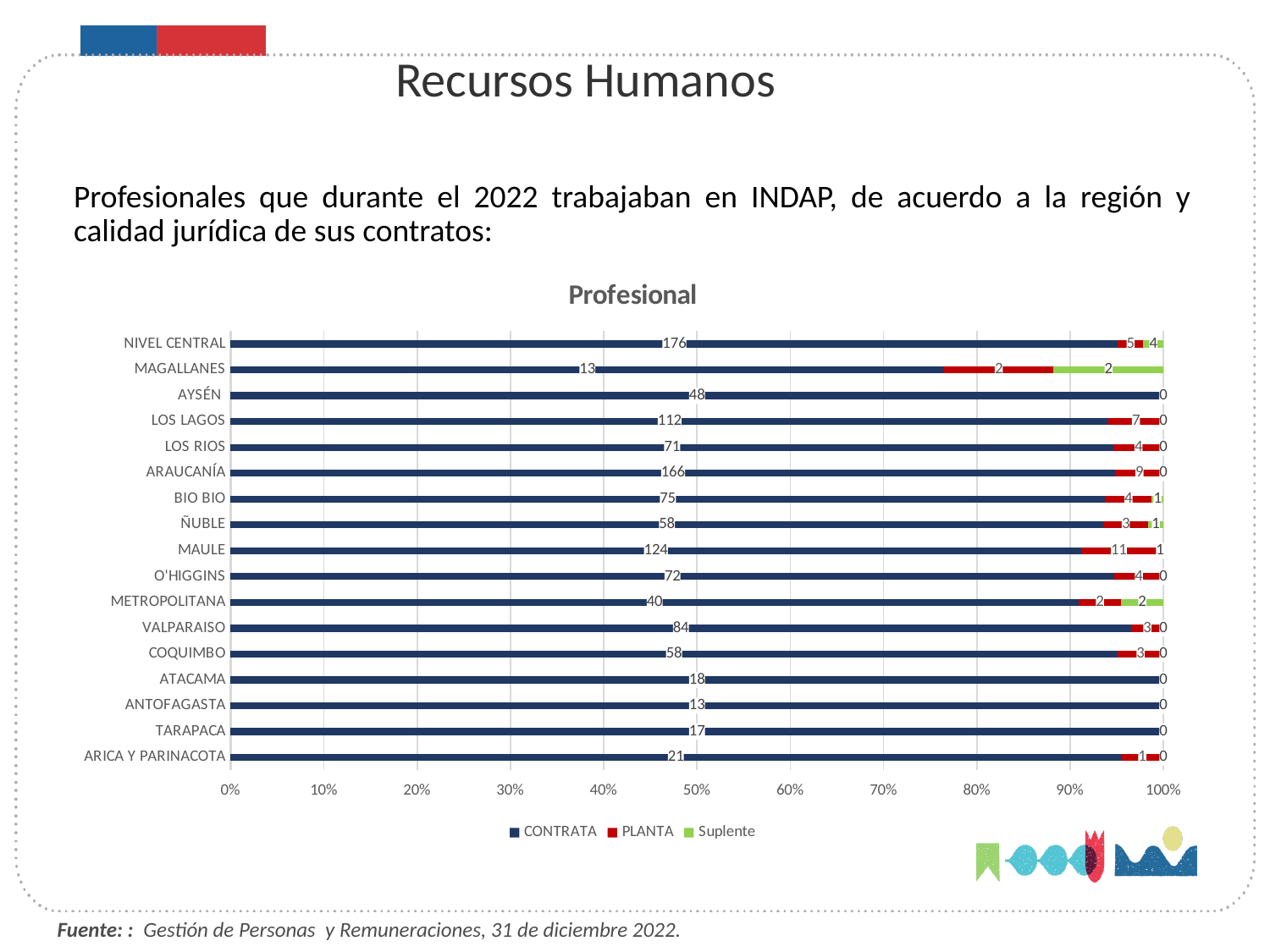
What kind of chart is shown? Stacked bar chart What is the CONTRATA value for NIVEL CENTRAL? 176 How many regions (categories) are shown on the chart? 17 Which region has the highest CONTRATA value? NIVEL CENTRAL What is the difference between the CONTRATA values for NIVEL CENTRAL and ARAUCANÍA? 10 Which region has the highest PLANTA value? MAULE How many series does the legend list? 3 What is the title of the chart? Profesional What is the PLANTA value for MAULE? 11 What is the Suplente value for MAGALLANES? 2 Which has a larger CONTRATA value, LOS LAGOS or MAULE? MAULE What is the total of the three values for MAULE? 136